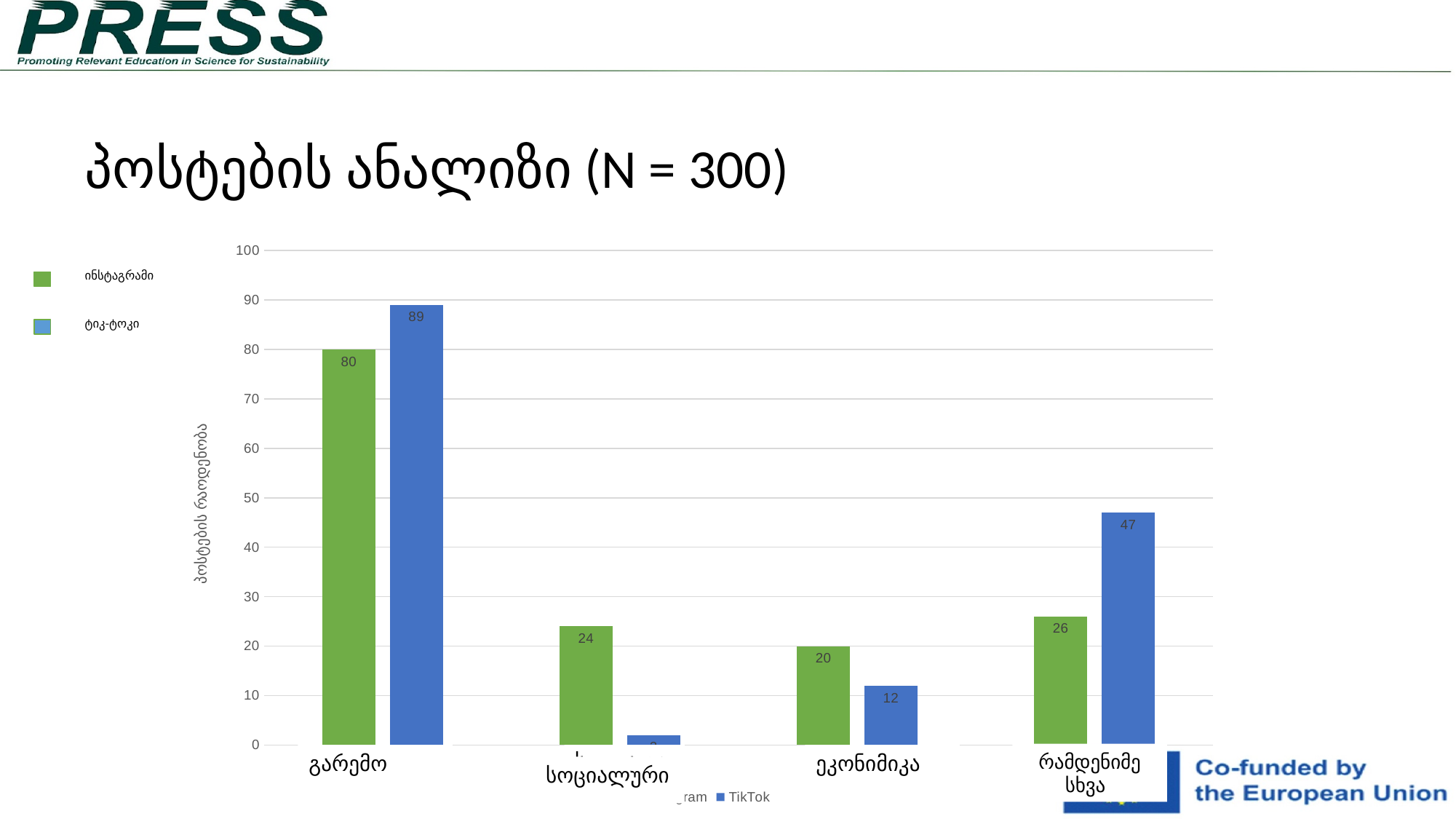
How many series does the legend list? 2 What is the ინსტაგრამი value for სოციალური? 24 What is the difference between the ტიკ-ტოკი and ინსტაგრამი values for რამდენიმე სხვა? 21 What is the ტიკ-ტოკი value for გარემო? 89 Which category has the lowest ინსტაგრამი value? ეკონომიკა For ეკონომიკა, which is larger: the ინსტაგრამი value or the ტიკ-ტოკი value? ინსტაგრამი What is the ტიკ-ტოკი value for ეკონომიკა? 12 What is the ტიკ-ტოკი value for რამდენიმე სხვა? 47 Is the ტიკ-ტოკი value for სოციალური greater or less than 10? less What is the ინსტაგრამი value for გარემო? 80 What type of chart is shown on the slide? bar chart Which category has the highest ტიკ-ტოკი value? გარემო